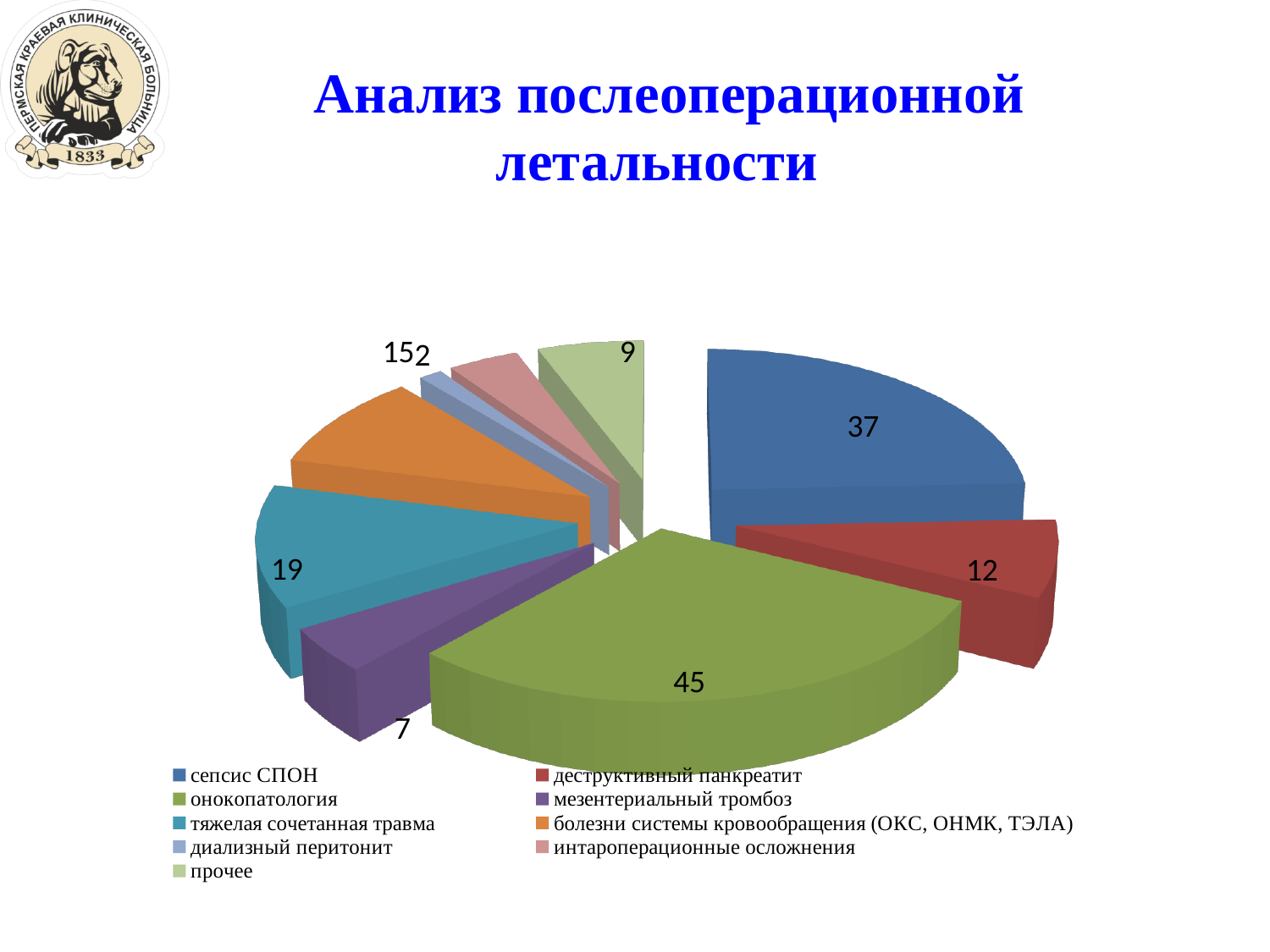
What is the value for деструктивный панкреатит? 12 What is the value for прочее? 9 What is the value for сепсис СПОН? 37 What is the value for мезентериальный тромбоз? 7 What kind of chart is shown on the slide? pie chart How many categories does the legend list? 9 Which category has the largest slice? онокопатология What is the value for онокопатология? 45 What is the title of the slide? Анализ послеоперационной летальности What is the difference between the values for онокопатология and сепсис СПОН? 8 Which is larger, сепсис СПОН or тяжелая сочетанная травма? сепсис СПОН What is the value for тяжелая сочетанная травма? 19